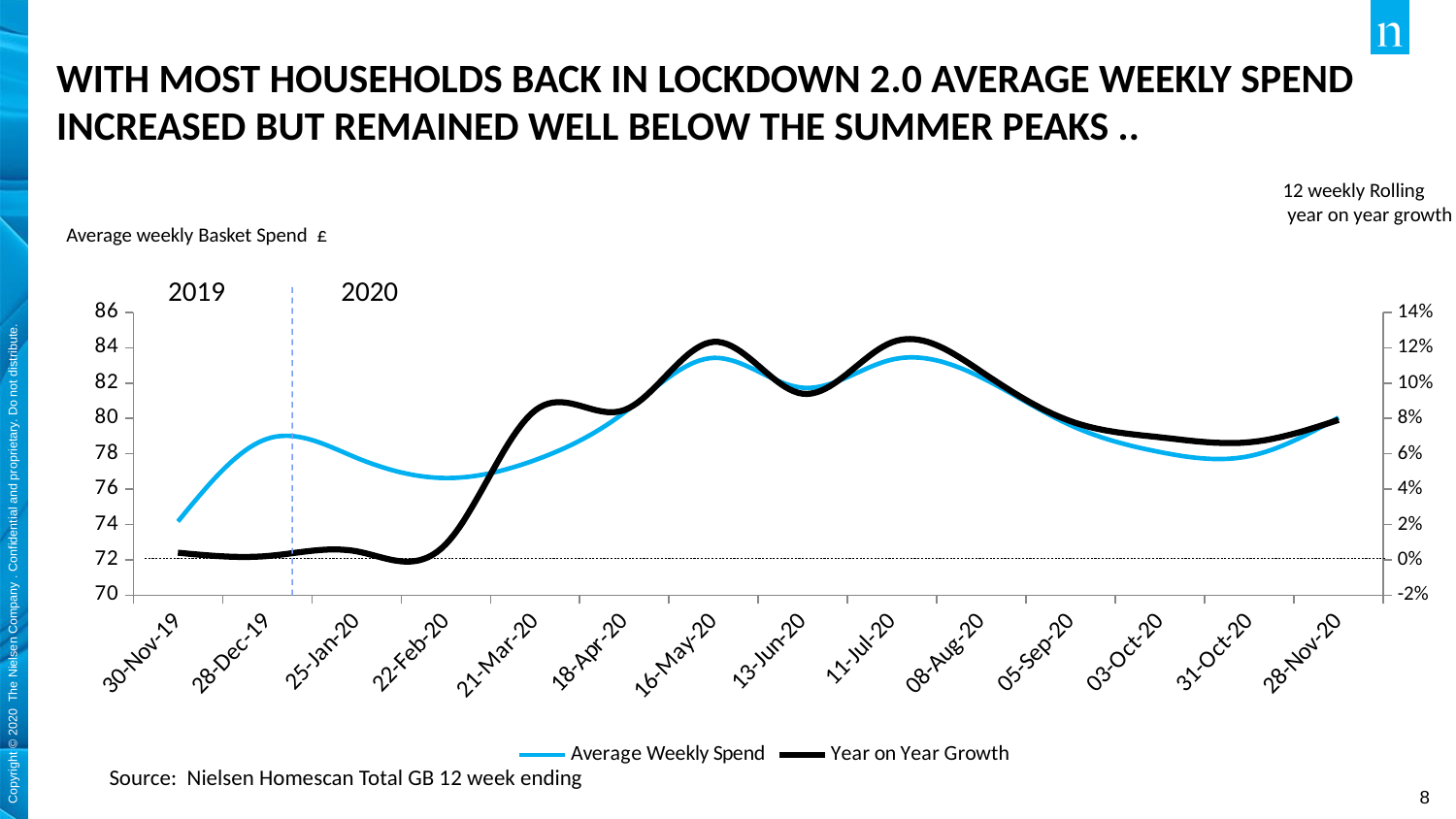
How many dates are labelled along the x axis? 14 What kind of chart is shown on the slide? line chart Is the Year on Year Growth higher on 16-May-20 or on 13-Jun-20? 16-May-20 Is the Average Weekly Spend higher on 28-Dec-19 or on 22-Feb-20? 28-Dec-19 Which date has the lowest Average Weekly Spend? 30-Nov-19 What is the label of the right-hand axis? 12 weekly Rolling year on year growth Is the Average Weekly Spend value for 16-May-20 greater or less than 82? greater Does the Average Weekly Spend rise or fall between 11-Jul-20 and 31-Oct-20? fall Is the Year on Year Growth value for 11-Jul-20 greater or less than 10%? greater How many series does the legend list? 2 Is the Average Weekly Spend value for 30-Nov-19 greater or less than 76? less